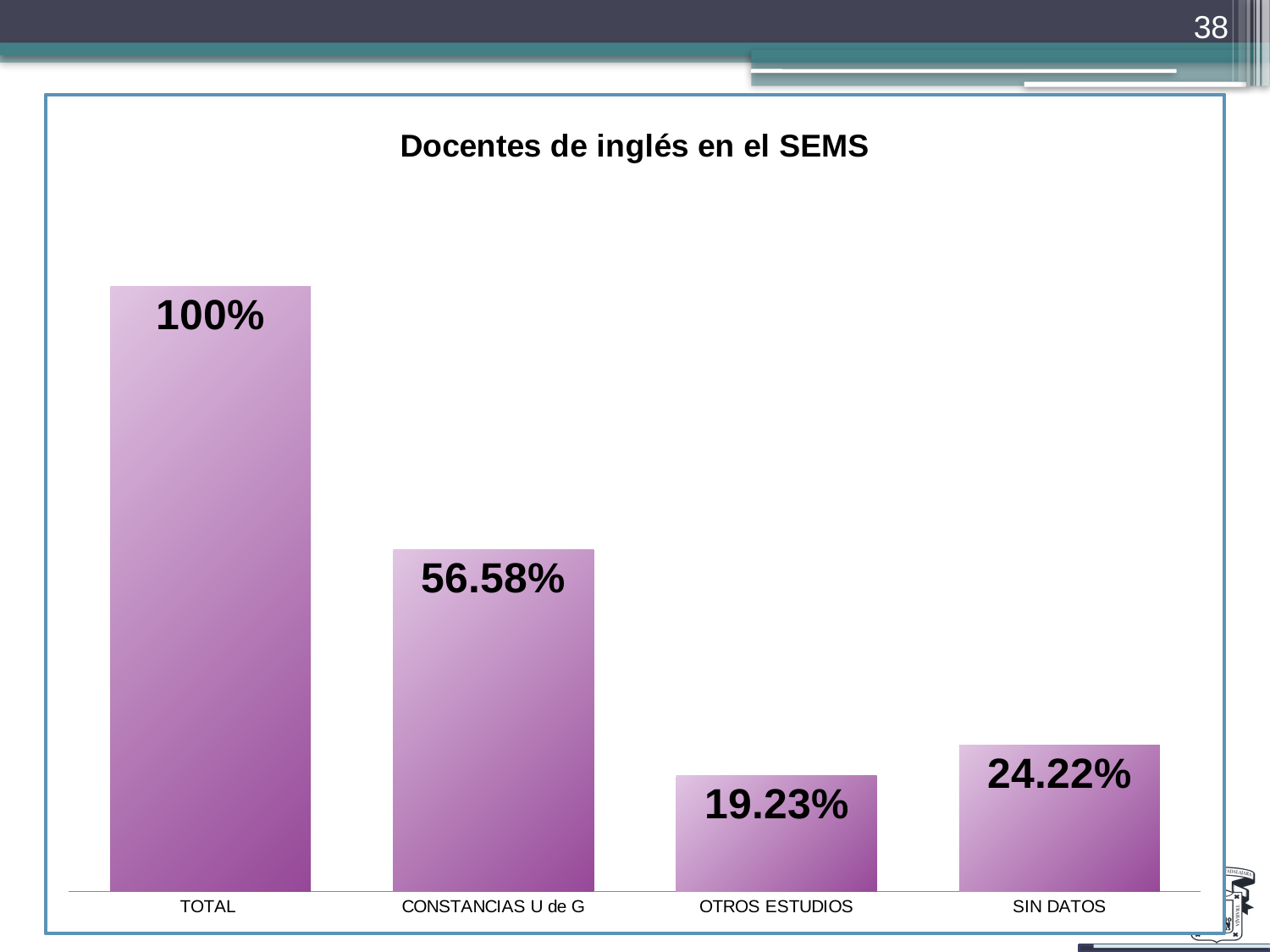
What is the value for CONSTANCIAS U de G? 56.58% What kind of chart is shown on the slide? Bar chart What is the value for TOTAL? 100% Which category has the lowest value? OTROS ESTUDIOS Which category has the highest value? TOTAL What is the difference between the values for SIN DATOS and OTROS ESTUDIOS? 4.99% How many categories are shown in the chart? 4 Which is larger, the value for OTROS ESTUDIOS or the value for SIN DATOS? SIN DATOS What is the difference between the values for CONSTANCIAS U de G and SIN DATOS? 32.36% What is the title of the chart? Docentes de inglés en el SEMS What is the value for SIN DATOS? 24.22% What is the value for OTROS ESTUDIOS? 19.23%